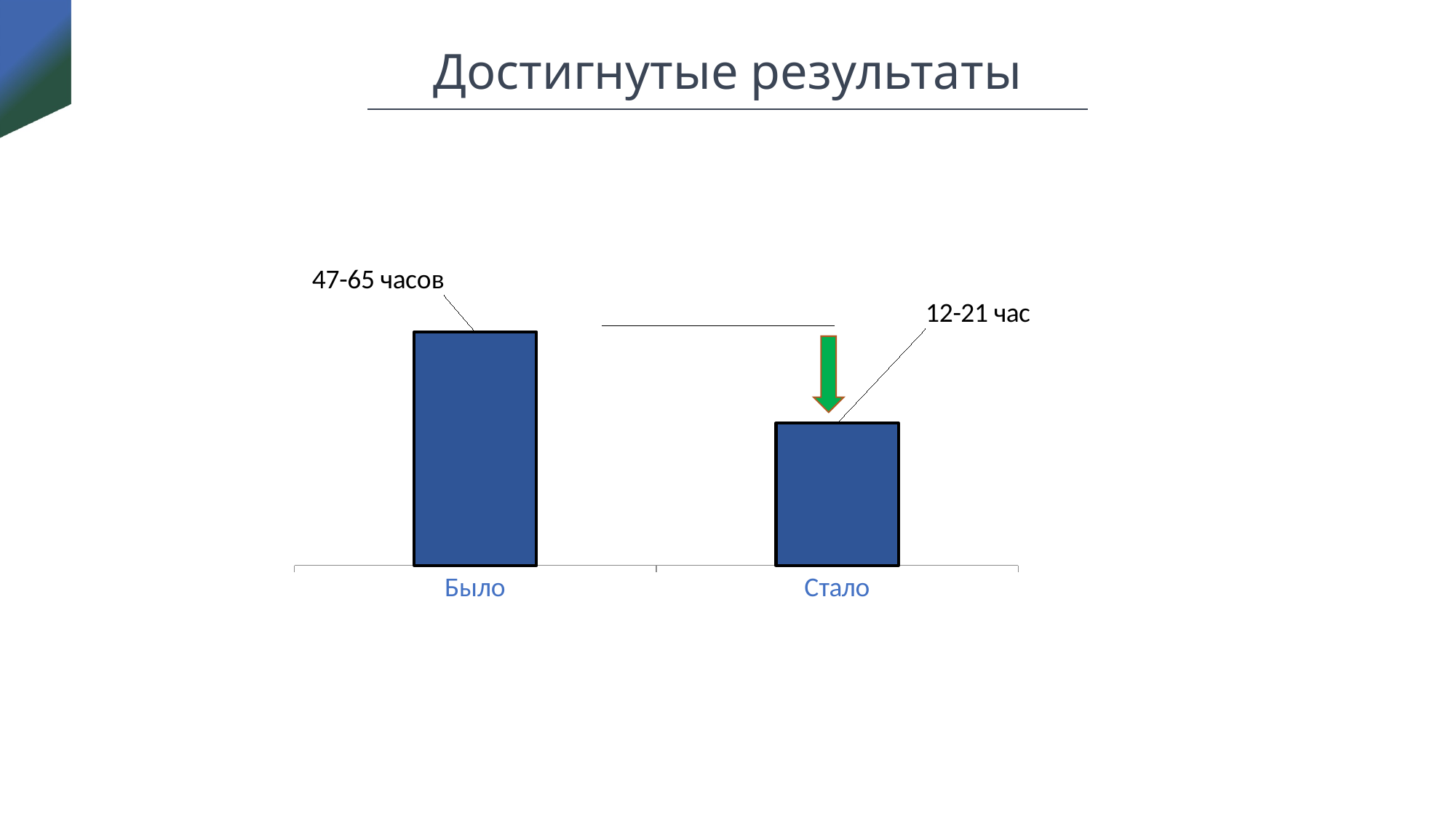
What is the label shown for the "Стало" bar? 12-21 час How many bars are plotted in the chart? 2 What kind of chart is shown on the slide? bar chart Which category has the highest value? Было Which category has the taller bar, "Было" or "Стало"? Было What is the title of the slide containing the chart? Достигнутые результаты Which category has the lowest value? Стало What colour are the bars in the chart? blue Do the values rise or fall from "Было" to "Стало"? fall What is the label shown for the "Было" bar? 47-65 часов